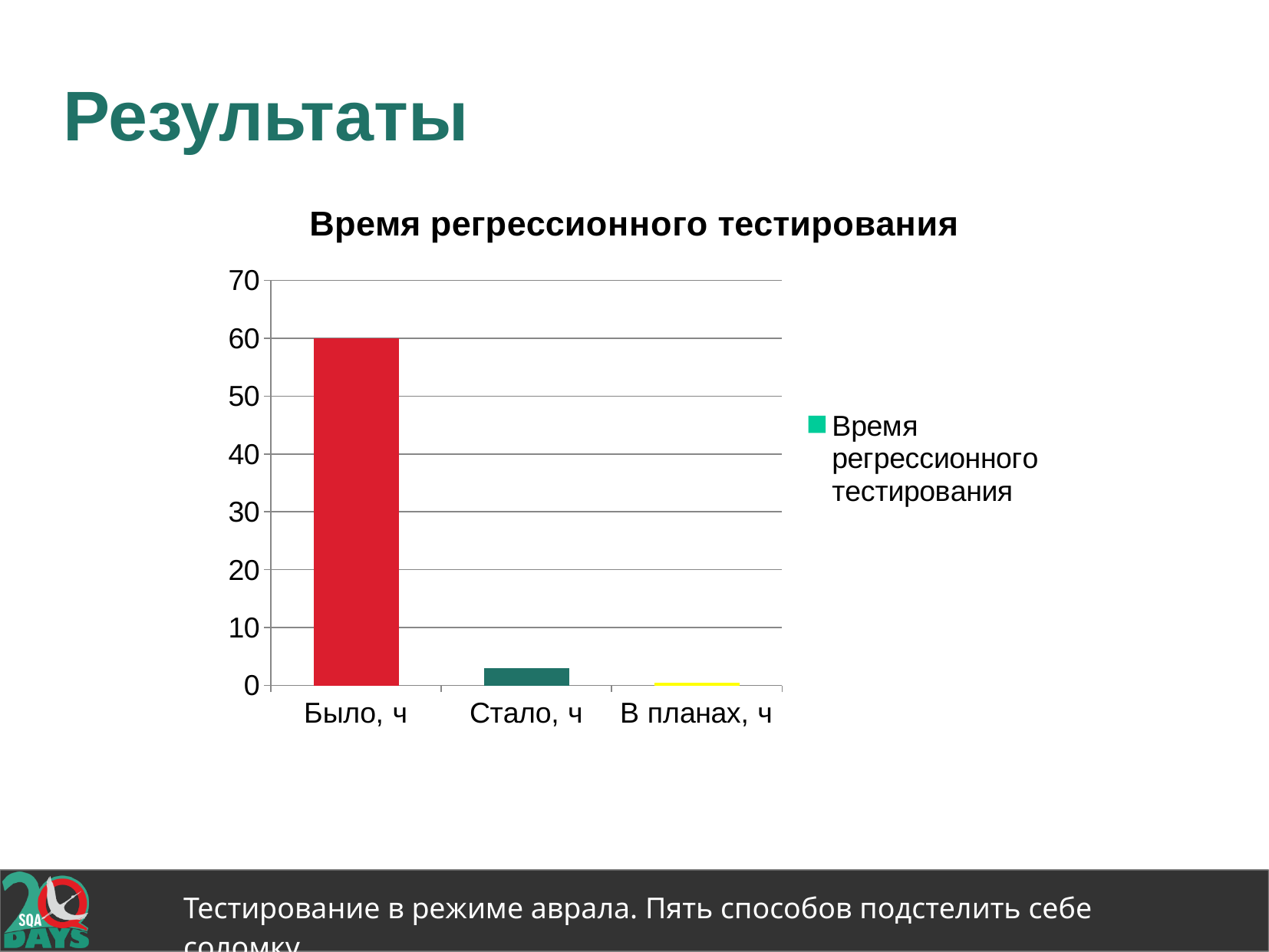
What is the title of the chart? Время регрессионного тестирования What is the value for Было, ч? 60 What kind of chart is shown on the slide? bar chart Do the values rise or fall from left to right along the x axis? fall Which category has the highest value? Было, ч Which is larger, the value for Стало, ч or the value for В планах, ч? Стало, ч Is the value for Стало, ч greater or less than 10? less How many categories are shown on the x axis of the chart? 3 What colour is the bar for Было, ч? red Which category has the lowest value? В планах, ч How many series does the legend list? 1 Is the value for Было, ч greater or less than 50? greater